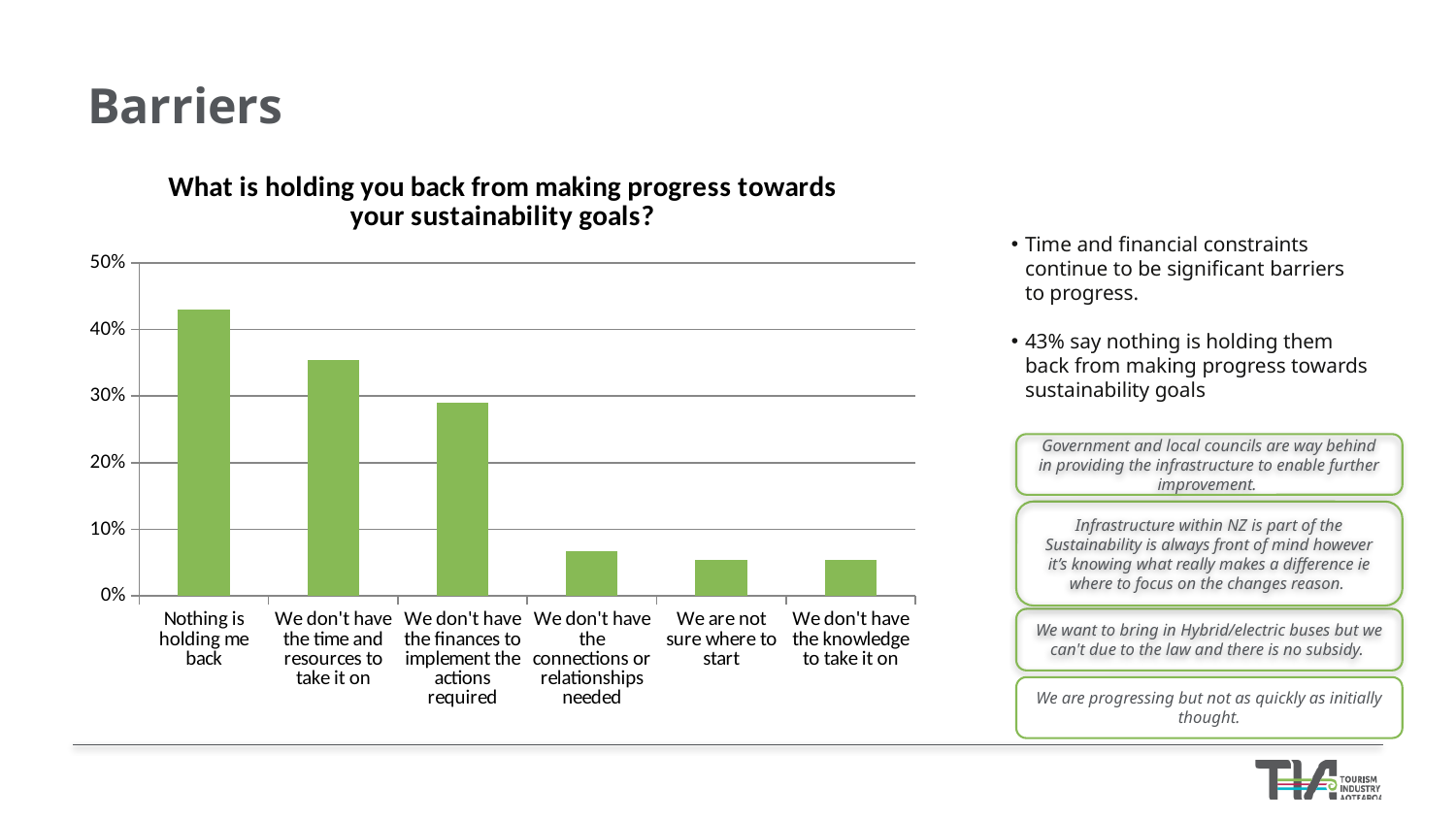
Is the value for 'We don't have the time and resources to take it on' greater or less than 30%? greater Which is larger: the value for 'We don't have the finances to implement the actions required' or the value for 'We don't have the knowledge to take it on'? We don't have the finances to implement the actions required Do the bar values generally rise or fall from left to right across the x axis? fall Is the value for 'We don't have the finances to implement the actions required' greater or less than 20%? greater Which is larger: the value for 'We don't have the time and resources to take it on' or the value for 'We don't have the finances to implement the actions required'? We don't have the time and resources to take it on Is the value for 'Nothing is holding me back' greater or less than 40%? greater What percentage of respondents say nothing is holding them back? 43% What kind of chart is shown on the slide? bar chart What is the title of the chart? What is holding you back from making progress towards your sustainability goals? Which category has the highest value in the chart? Nothing is holding me back How many categories are shown on the x axis of the chart? 6